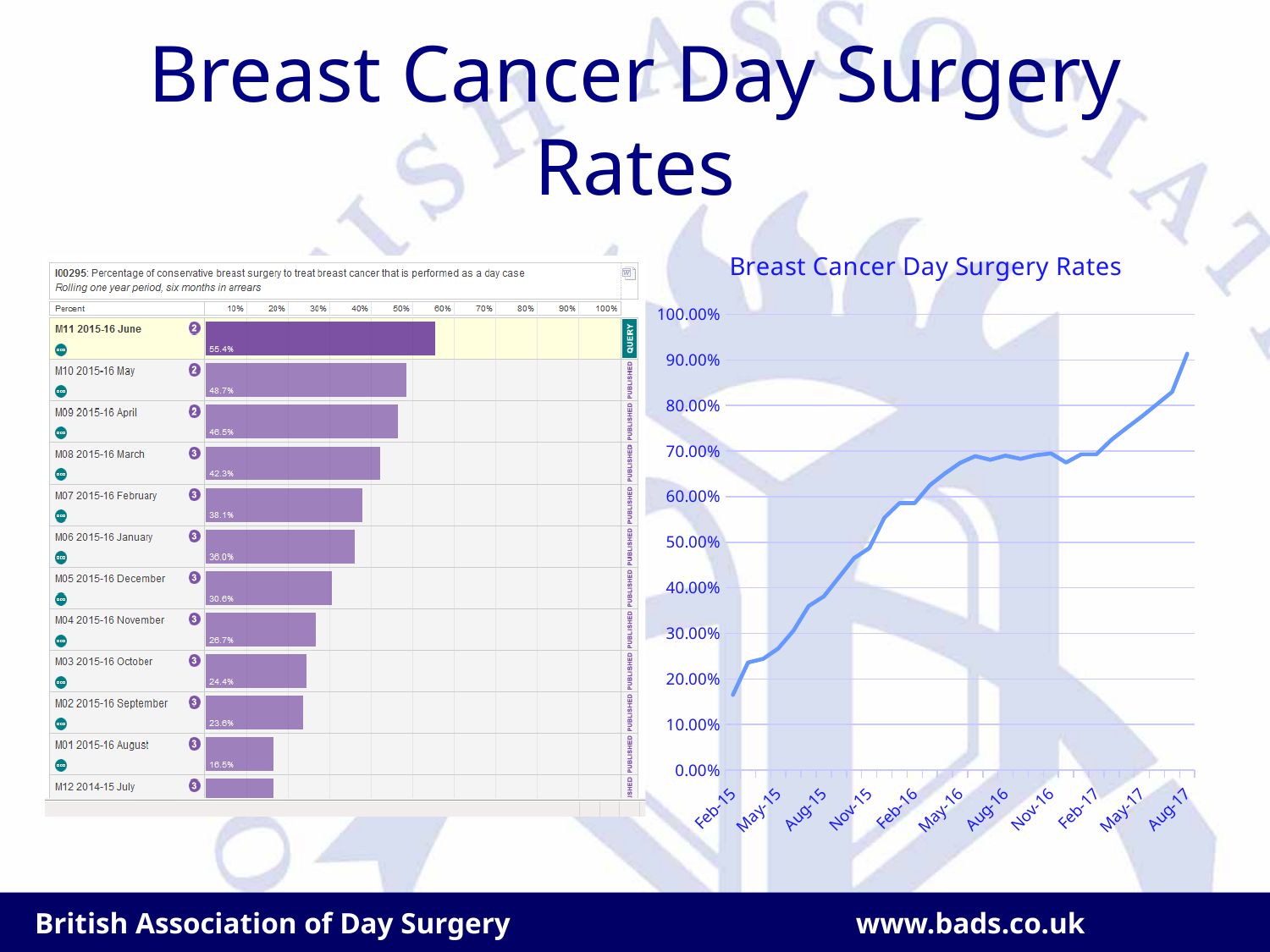
On the right chart, is the value for Feb-16 greater or less than 50.00%? greater On the left chart, what is the value for M05 2015-16 December? 30.6% On the right chart, is the value for May-17 greater or less than 70.00%? greater On the right chart, is the value for Feb-15 greater or less than 20.00%? less On the left chart, which labelled month has the highest value? M11 2015-16 June On the right chart, do the values generally rise or fall from Feb-15 to Aug-17? Rise On the left chart, what is the value for M01 2015-16 August? 16.5% On the left chart, which is larger, the value for M03 2015-16 October or M02 2015-16 September? M03 2015-16 October On the left chart, what is the difference between the values for M11 2015-16 June and M10 2015-16 May? 6.7% What kind of chart is the chart on the right titled 'Breast Cancer Day Surgery Rates'? Line chart On the left chart, what is the difference between the values for M08 2015-16 March and M07 2015-16 February? 4.2% On the left chart, what is the value for M11 2015-16 June? 55.4%